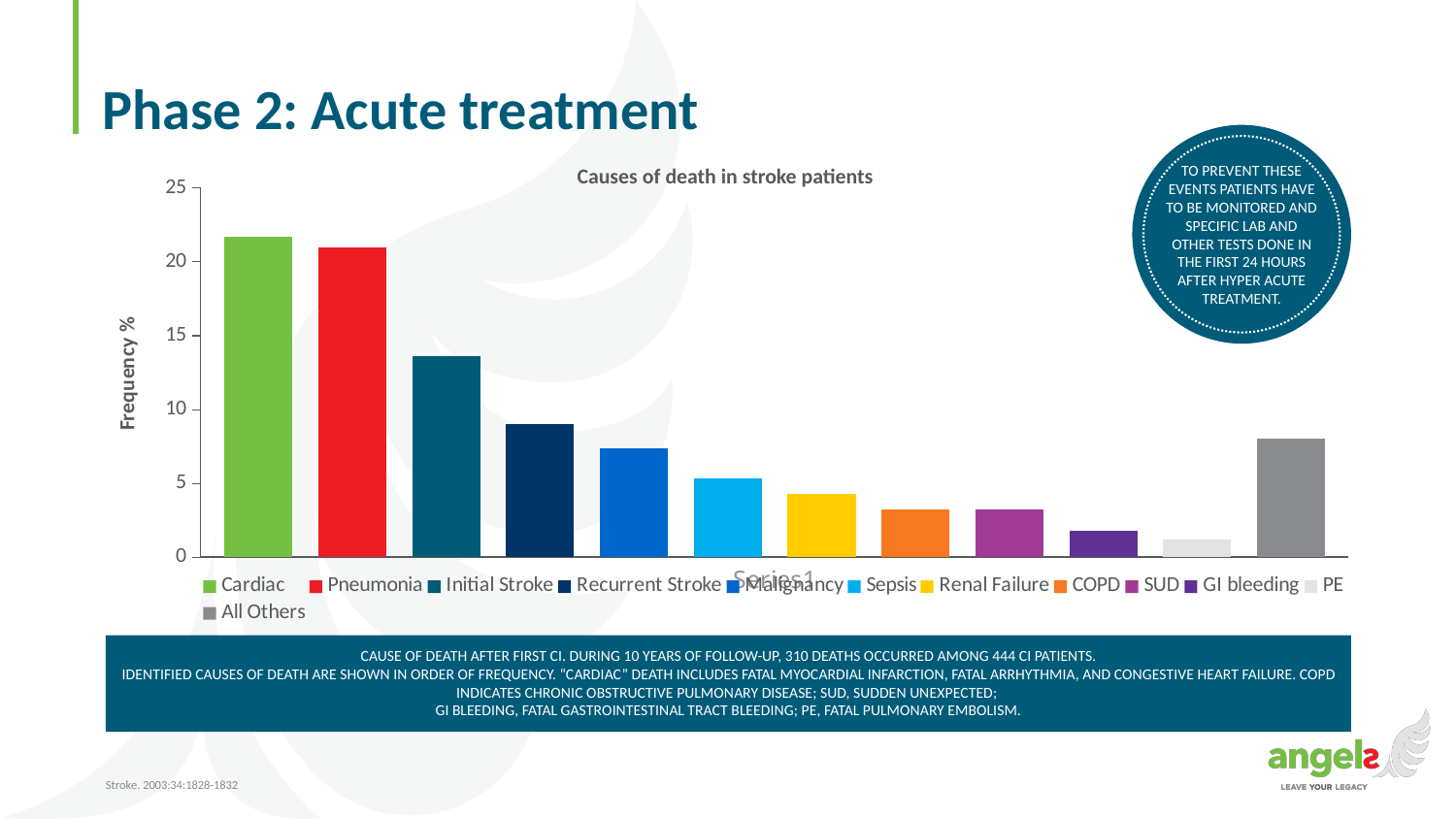
Is the value for Initial Stroke greater or less than 10? greater Which has a higher frequency, All Others or Sepsis? All Others How many causes of death are plotted as bars in the chart? 12 Which has a higher frequency, Initial Stroke or Recurrent Stroke? Initial Stroke Is the value for All Others greater or less than 5? greater What kind of chart is shown on the slide? Bar chart Is the value for Recurrent Stroke greater or less than 10? less What is the title of the chart? Causes of death in stroke patients Which cause of death has the lowest frequency in the chart? PE What is the label on the vertical axis of the chart? Frequency %